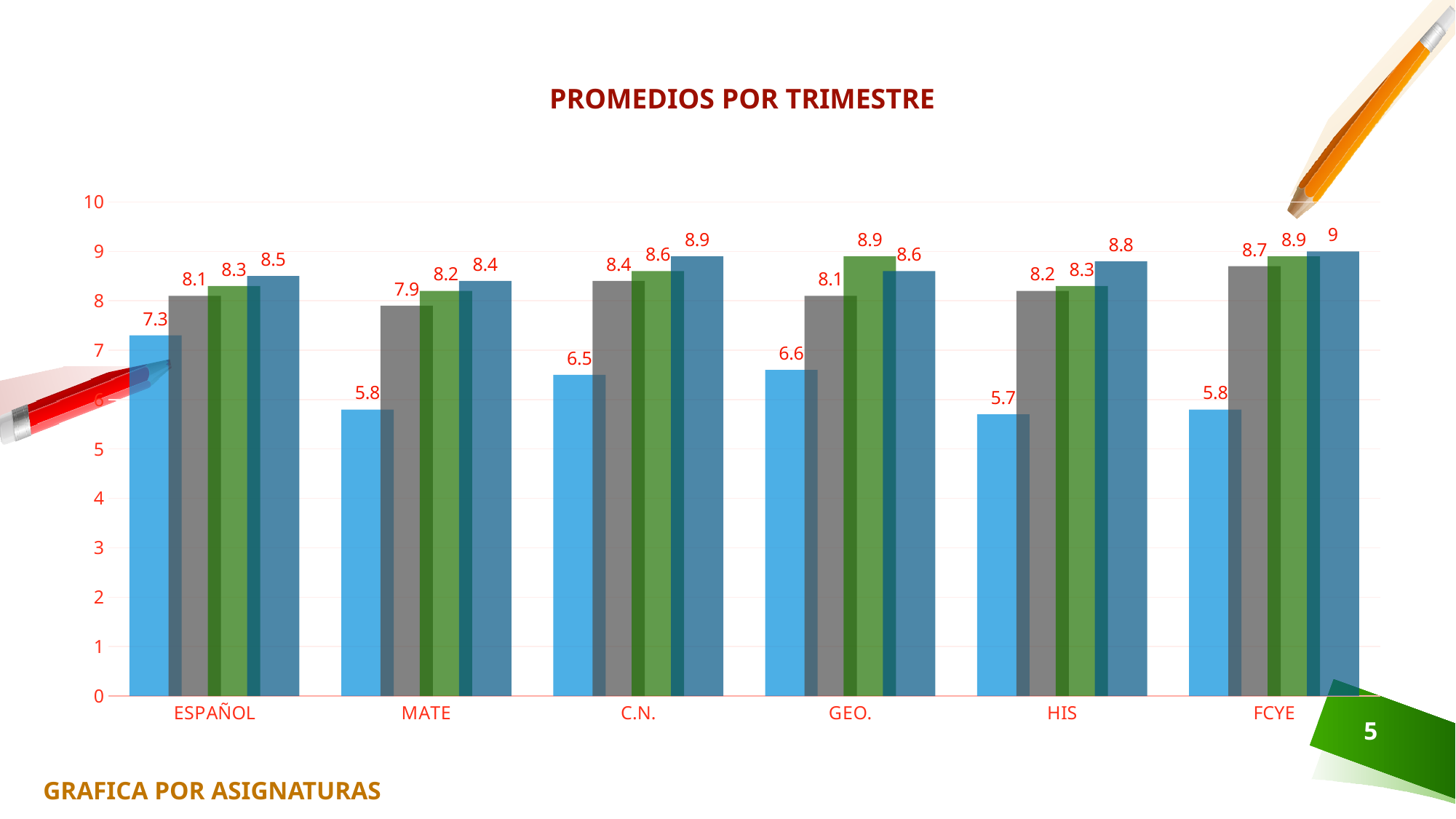
What is the value of the second (gray) bar for MATE? 7.9 What is the title of the chart? PROMEDIOS POR TRIMESTRE How many subject categories are shown on the x axis? 6 What is the difference between the last (dark blue) bar and the first (light blue) bar for HIS? 3.1 What is the value of the last (dark blue) bar for FCYE? 9 Which subject has the highest value for the last (dark blue) bar? FCYE What is the value of the first (light blue) bar for ESPAÑOL? 7.3 What kind of chart is shown on the slide? bar chart Is the value of the first (light blue) bar for C.N. greater or less than 7? less For GEO., which is larger: the third (green) bar or the fourth (dark blue) bar? the third (green) bar How many bars are plotted for each subject category? 4 Which subject has the lowest value for the first (light blue) bar? HIS